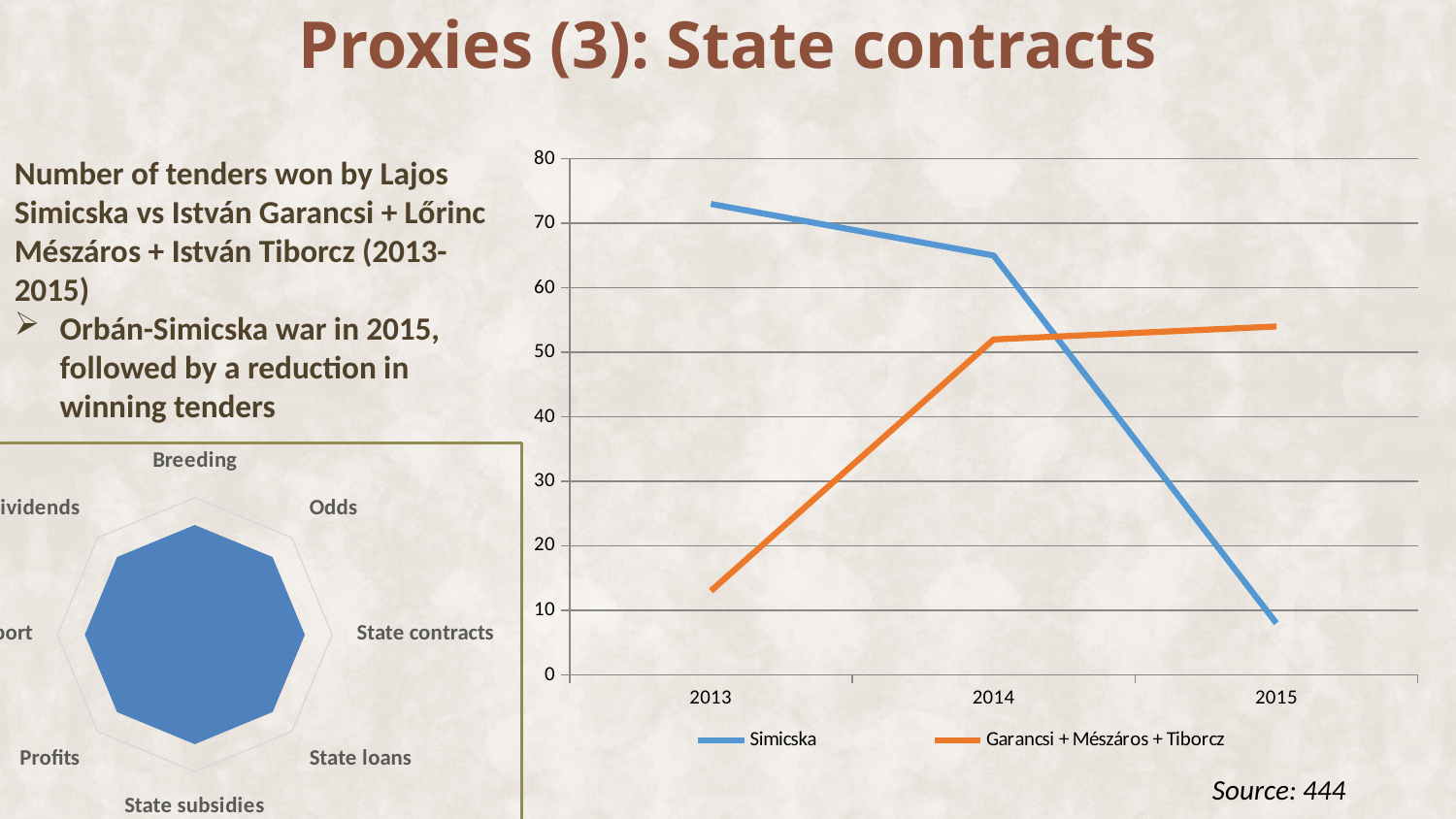
On the line chart on the right, which series has the higher value in 2015, Simicska or Garancsi + Mészáros + Tiborcz? Garancsi + Mészáros + Tiborcz On the line chart on the right, which series has the higher value in 2014, Simicska or Garancsi + Mészáros + Tiborcz? Simicska On the line chart on the right, how many years are shown on the x axis? 3 On the line chart on the right, is the value for Garancsi + Mészáros + Tiborcz in 2013 greater or less than 20? less On the line chart on the right, what kind of chart is it? line chart On the line chart on the right, does the Garancsi + Mészáros + Tiborcz line rise or fall from 2013 to 2015? rise On the line chart on the right, does the Simicska line rise or fall from 2013 to 2015? fall On the line chart on the right, is the value for Simicska in 2013 greater or less than 60? greater On the line chart on the right, what colour is the Simicska line? blue On the line chart on the right, is the value for Simicska in 2015 greater or less than 20? less On the line chart on the right, how many series does the legend list? 2 On the line chart on the right, in which year is the Simicska value highest? 2013